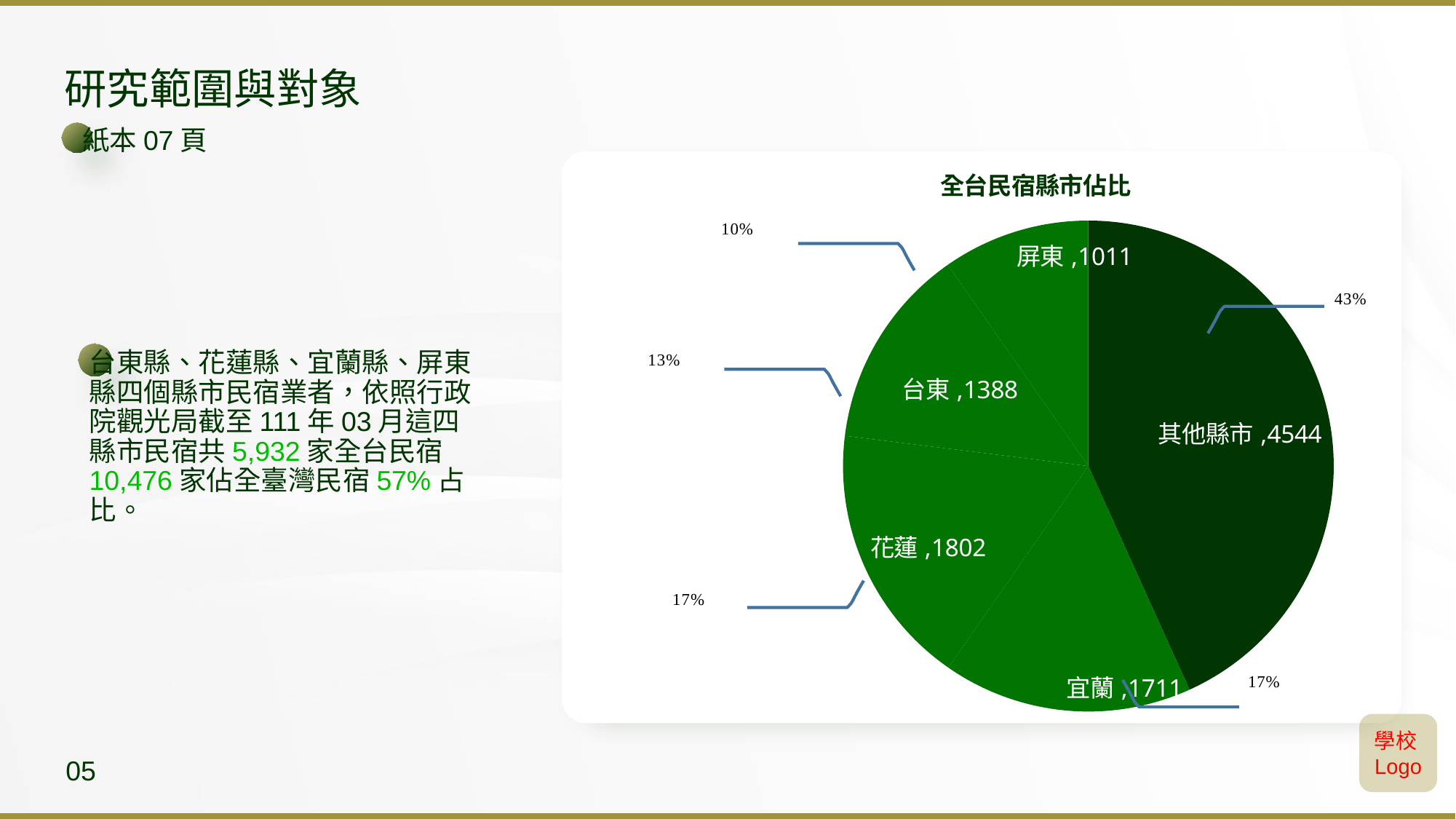
What is the value shown for 台東 in the pie chart? 1388 How many slices does the pie chart have? 5 Which has a larger value, 花蓮 or 宜蘭? 花蓮 What kind of chart is shown on the slide? pie chart What is the value shown for 其他縣市 in the pie chart? 4544 What is the title of the chart? 全台民宿縣市佔比 What is the value shown for 屏東 in the pie chart? 1011 Which category has the largest slice in the pie chart? 其他縣市 What is the difference between the values for 花蓮 and 宜蘭? 91 Which category has the smallest slice in the pie chart? 屏東 What share of the pie does 屏東 represent? 10% What share of the pie does 其他縣市 represent? 43%